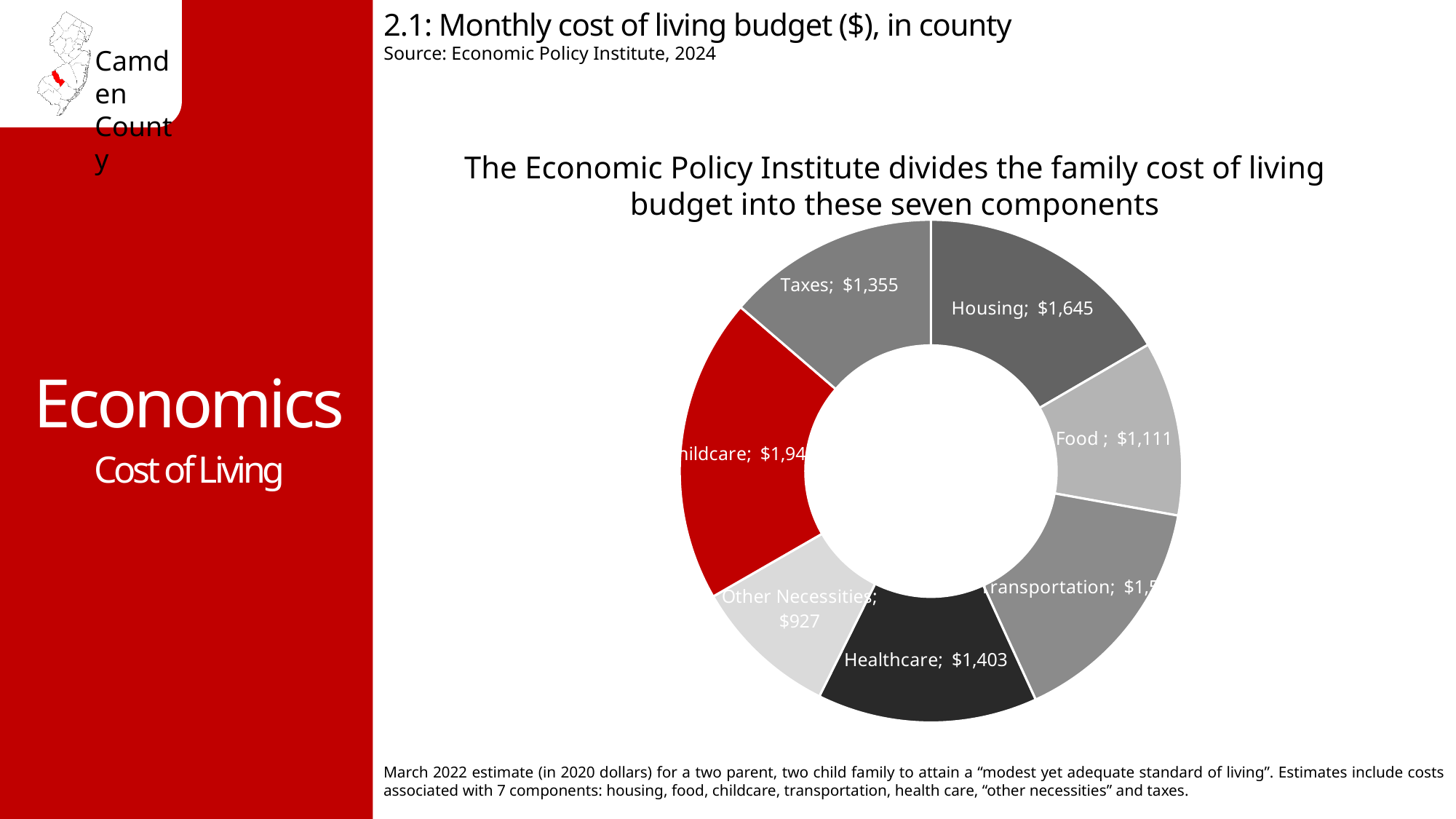
How many components are shown in the chart? 7 Which component has the smallest monthly cost in the chart? Other Necessities What is the monthly cost for Other Necessities in the chart? $927 What is the monthly cost for Healthcare in the chart? $1,403 What is the monthly cost for Taxes in the chart? $1,355 Which component has the largest monthly cost in the chart? Childcare What is the difference between the Healthcare and Food monthly costs? $292 What is the difference between the Housing and Taxes monthly costs? $290 Which is larger, the monthly cost for Housing or for Healthcare? Housing What kind of chart is shown on the slide? Pie (donut) chart What is the monthly cost for Food in the chart? $1,111 What is the monthly cost for Housing in the chart? $1,645